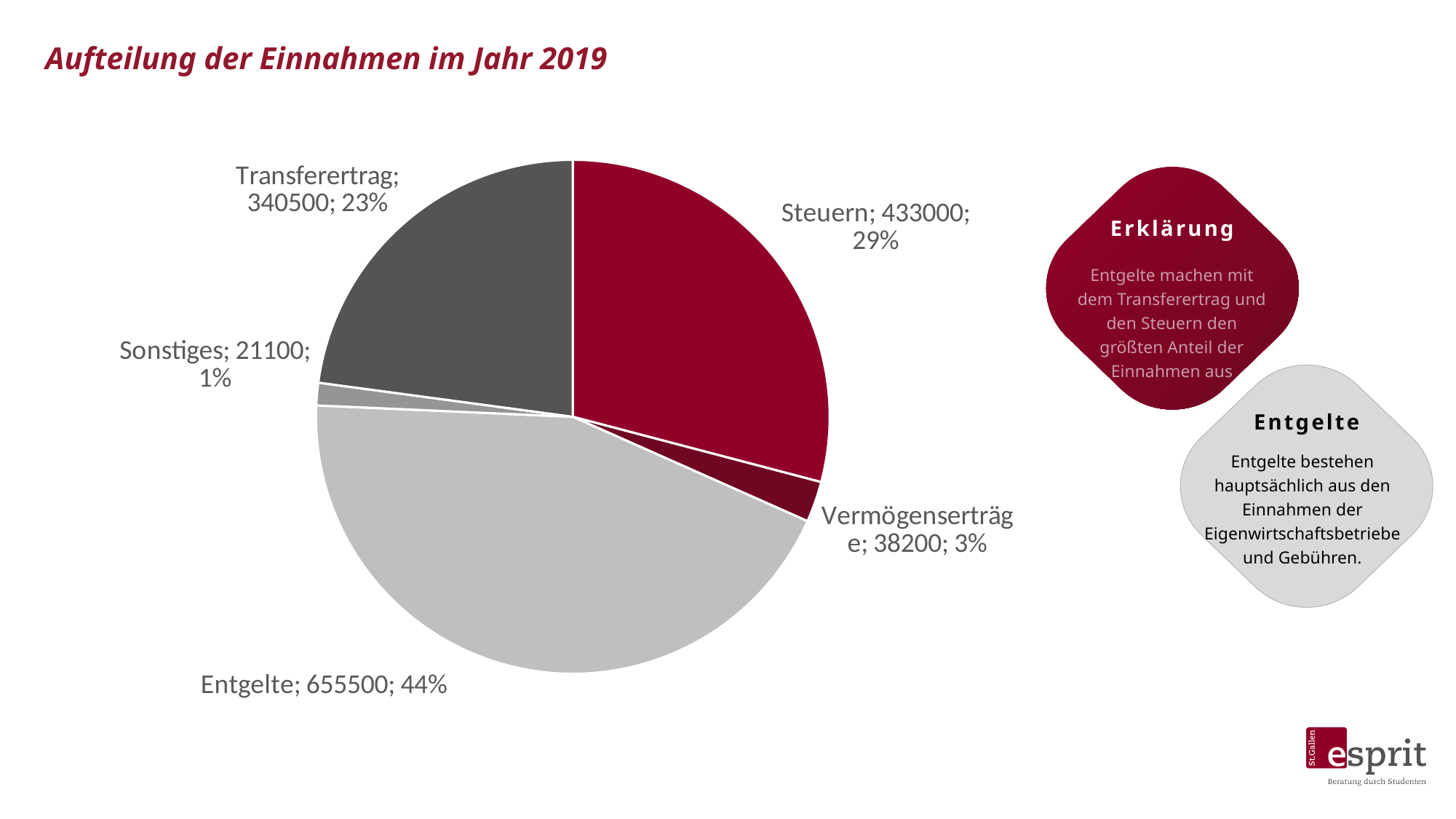
What is the value for Transferertrag? 340500 What share of the pie does Entgelte represent? 44% Which category has the smallest slice? Sonstiges How many slices does the pie chart have? 5 What share of the pie does Sonstiges represent? 1% What is the value for Steuern? 433000 What is the value for Vermögenserträge? 38200 Which is larger, Transferertrag or Vermögenserträge? Transferertrag Which category has the largest slice? Entgelte What kind of chart is shown on the slide? pie chart What is the difference between the values for Steuern and Transferertrag? 92500 What is the value for Entgelte? 655500